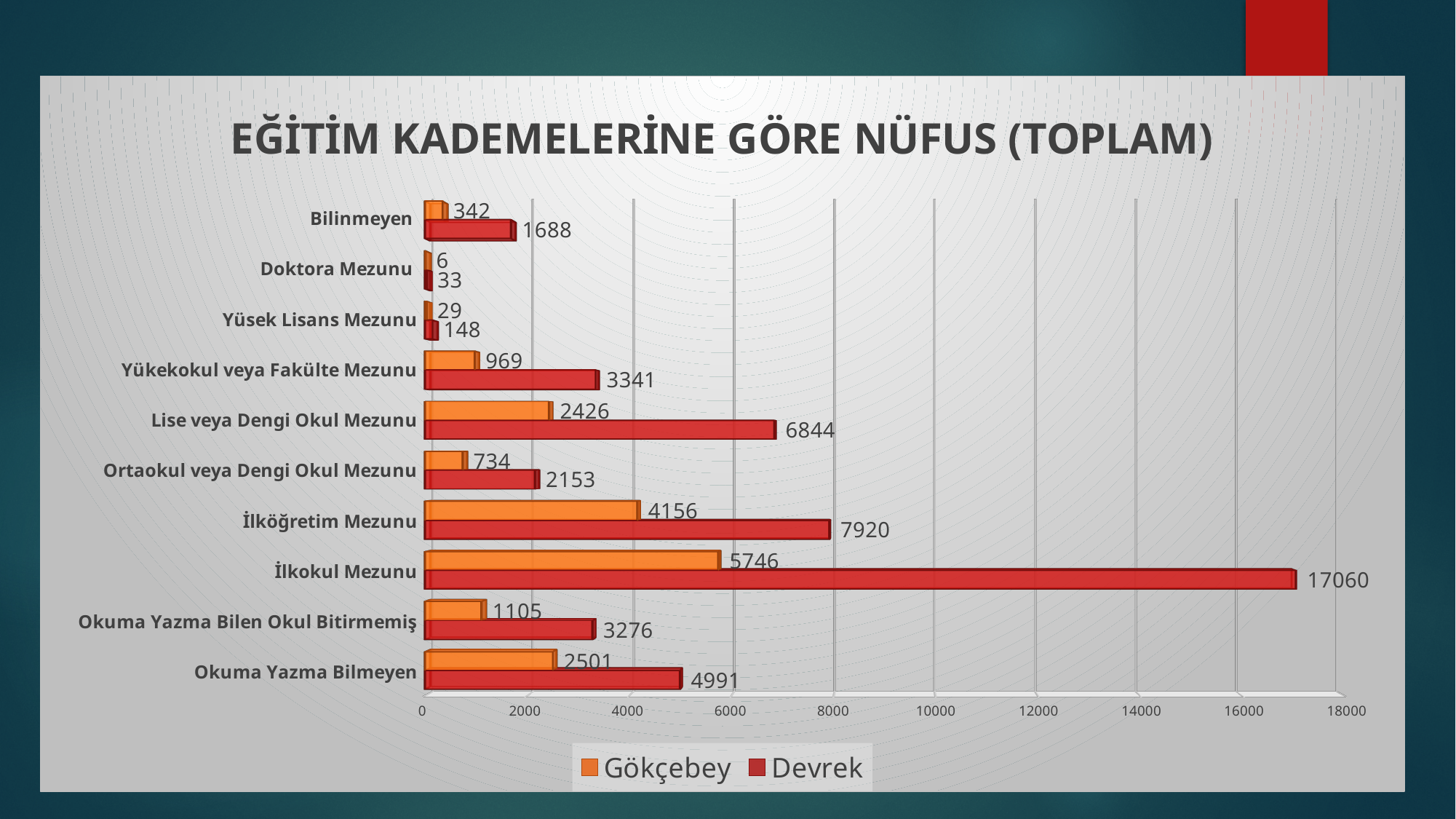
Which category has the highest Devrek value? İlkokul Mezunu How many series does the legend list? 2 Is the Devrek value for Lise veya Dengi Okul Mezunu greater or less than 6000? greater How many education categories are shown on the chart? 10 What is the title of the chart? EĞİTİM KADEMELERİNE GÖRE NÜFUS (TOPLAM) Which category has the lowest Gökçebey value? Doktora Mezunu What is the Gökçebey value for Lise veya Dengi Okul Mezunu? 2426 What is the Devrek value for İlkokul Mezunu? 17060 What is the difference between the Devrek and Gökçebey values for İlköğretim Mezunu? 3764 What kind of chart is shown on the slide? Bar chart What is the Devrek value for Doktora Mezunu? 33 Which is larger: the Gökçebey value for Okuma Yazma Bilmeyen or the Gökçebey value for Okuma Yazma Bilen Okul Bitirmemiş? Okuma Yazma Bilmeyen